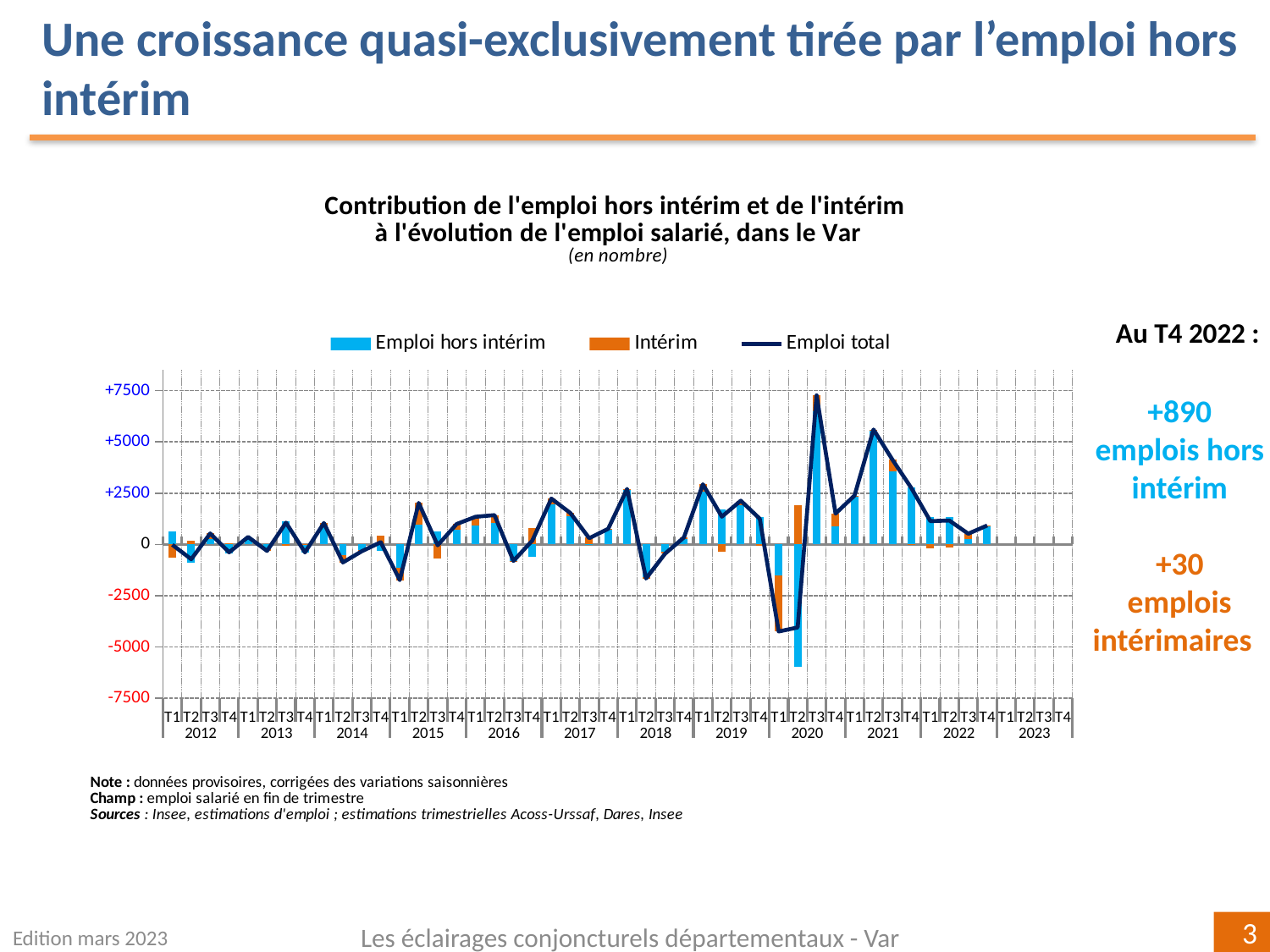
What is the title of the chart? Contribution de l'emploi hors intérim et de l'intérim à l'évolution de l'emploi salarié, dans le Var In which quarter does the Emploi total line reach its highest value? T3 2020 According to the slide, what is the value for Intérim (emplois intérimaires) at T4 2022? +30 In which quarter is the Emploi hors intérim bar at its lowest value? T2 2020 Which is larger, the Emploi total value at T3 2020 or at T1 2021? T3 2020 According to the slide, what is the value for Emploi hors intérim at T4 2022? +890 Is the value of Emploi total at T3 2020 greater or less than 5000? greater What are the three series named in the chart legend? Emploi hors intérim, Intérim, Emploi total What kind of chart is shown on the slide? A bar chart combined with a line How many series does the chart legend list? 3 Is the value of Emploi total at T2 2020 greater or less than -2500? less